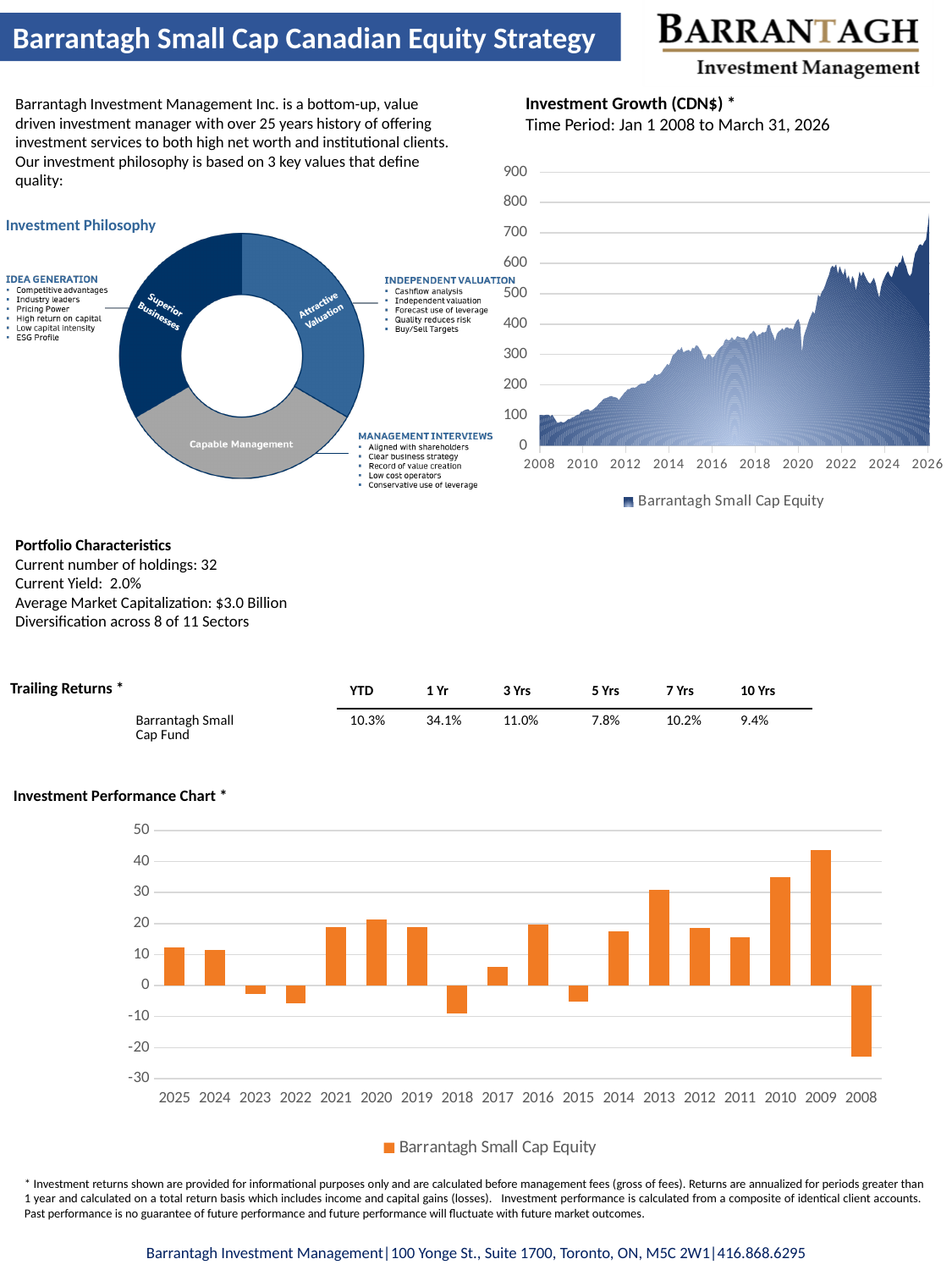
In the Investment Performance Chart, is the value for 2010 greater or less than 30? greater How many series does the legend of the Investment Performance Chart list? 1 What kind of chart is the Investment Performance Chart? bar chart In the Investment Performance Chart, is the value for 2009 greater or less than 40? greater What series name appears in the legend of the Investment Growth (CDN$) chart? Barrantagh Small Cap Equity In the Investment Performance Chart, which year has the highest return? 2009 How many years are shown on the x axis of the Investment Performance Chart? 18 In the Investment Growth (CDN$) chart, is the value at the end of the period in 2026 greater or less than 700? greater What kind of chart is the Investment Growth (CDN$) chart? area chart In the Investment Performance Chart, which year has the larger value, 2013 or 2012? 2013 In the Investment Performance Chart, which year has the lowest return? 2008